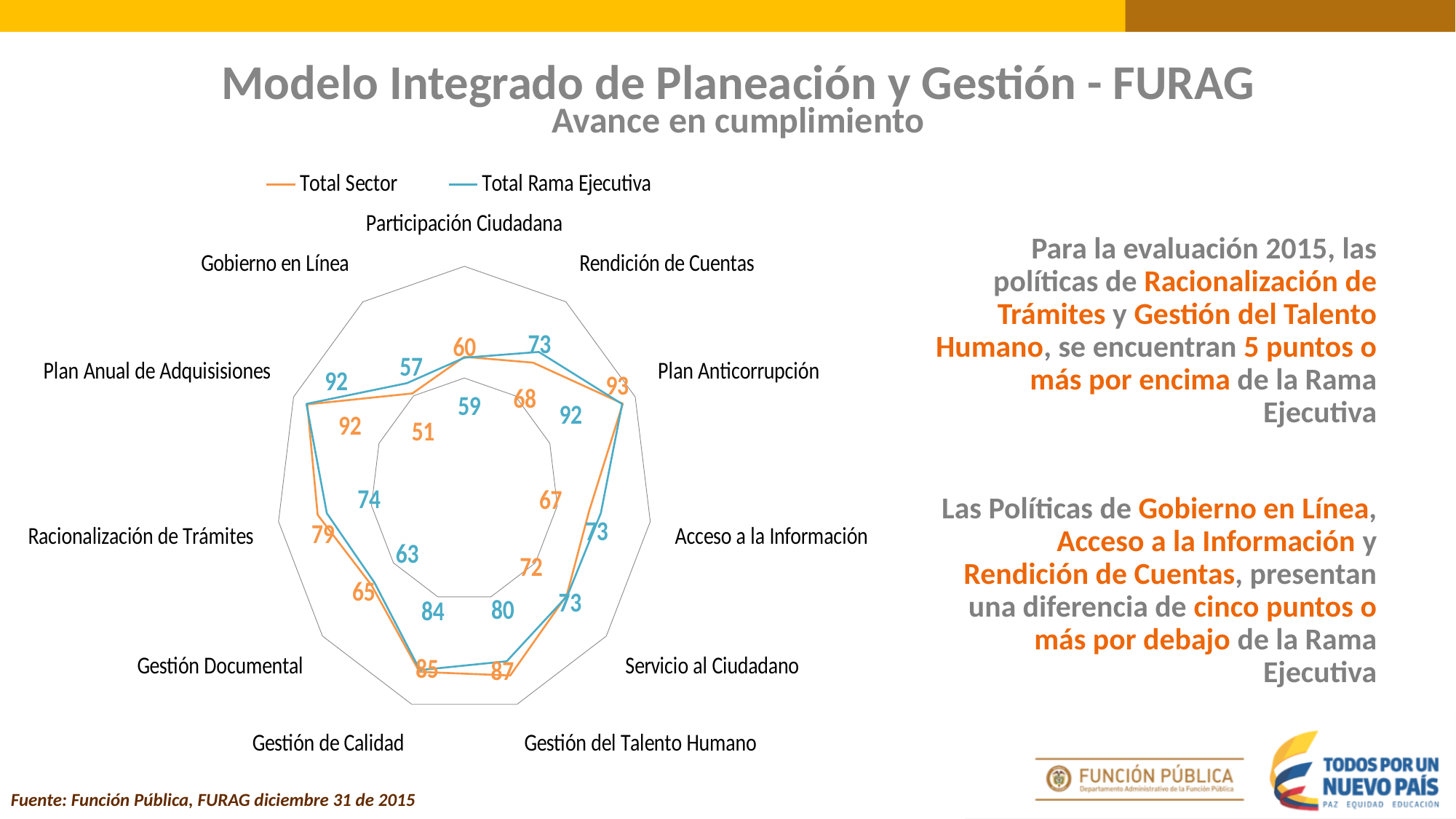
What is the Total Rama Ejecutiva value for Racionalización de Trámites? 74 What is the difference between the Total Sector and Total Rama Ejecutiva values for Gestión del Talento Humano? 7 Which colour represents the Total Sector series in the chart? Orange How many categories (policies) are plotted on the radar chart? 11 What is the Total Rama Ejecutiva value for Gobierno en Línea? 57 What is the Total Sector value for Plan Anticorrupción? 93 How many series does the chart legend list? 2 What is the Total Sector value for Gestión del Talento Humano? 87 For Acceso a la Información, which series has the larger value: Total Sector or Total Rama Ejecutiva? Total Rama Ejecutiva Which category has the lowest Total Sector value? Gobierno en Línea Which category has the highest Total Sector value? Plan Anticorrupción What kind of chart is shown on the slide? Radar chart